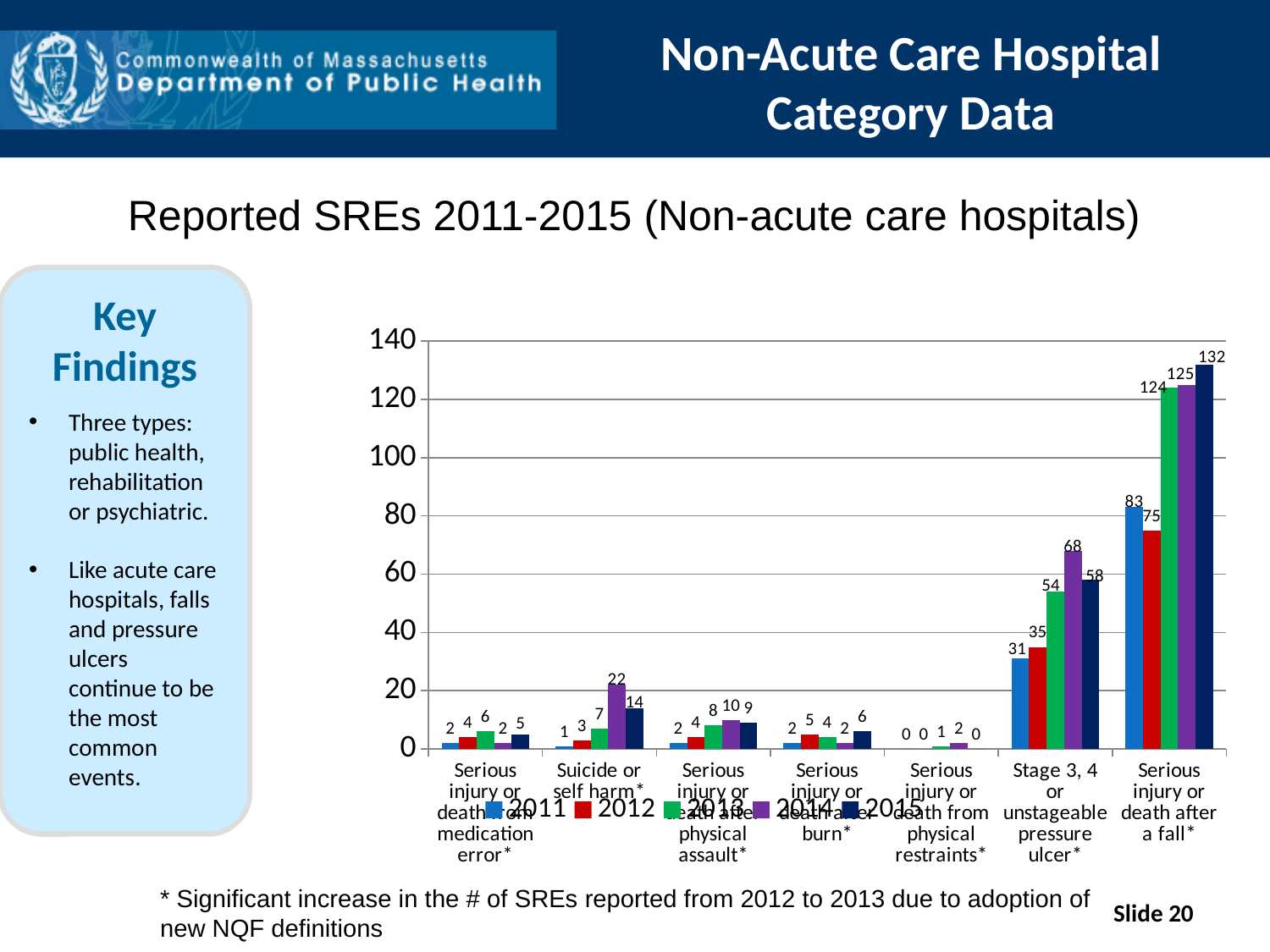
How many series does the legend list? 5 How many categories are shown on the x axis? 7 What is the title of the chart? Reported SREs 2011-2015 (Non-acute care hospitals) What type of chart is shown on the slide? bar chart Which year has the lowest value in the 'Serious injury or death after a fall*' category? 2012 What is the value for 2014 in the 'Suicide or self harm*' category? 22 Is the 2013 value for 'Serious injury or death after a fall*' greater or less than 120? greater What is the difference between the 2015 and 2011 values for 'Serious injury or death after a fall*'? 49 Which is larger: the 2014 value or the 2015 value for 'Stage 3, 4 or unstageable pressure ulcer*'? 2014 What is the value for 2014 in the 'Stage 3, 4 or unstageable pressure ulcer*' category? 68 What is the value for 2015 in the 'Serious injury or death after a fall*' category? 132 Which category has the highest value for 2013? Serious injury or death after a fall*